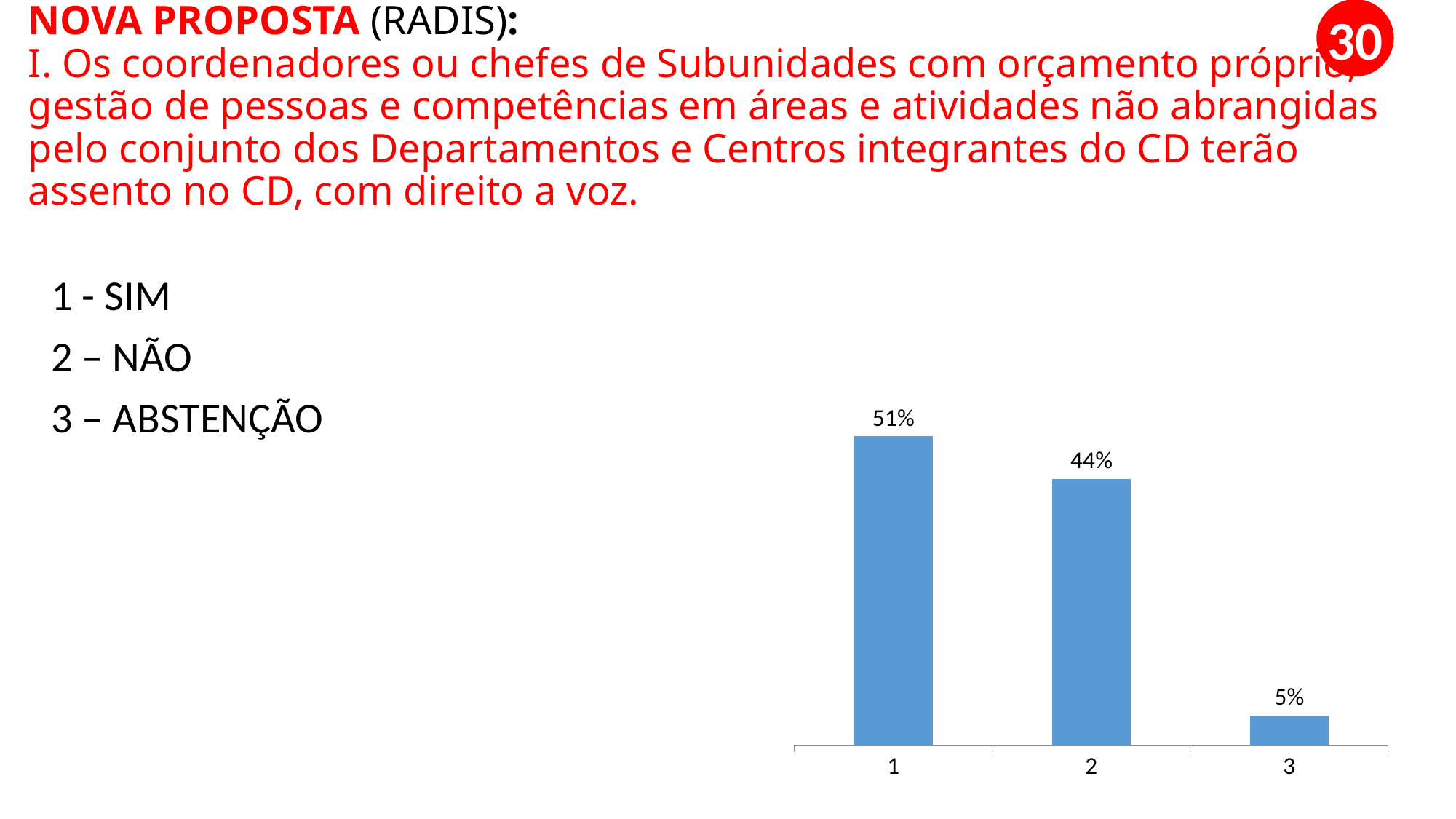
What is the value shown for category 3? 5% What is the value shown for category 1? 51% Which is larger, the value for category 1 or the value for category 3? category 1 What colour are the bars in the chart? blue How many bars are plotted in the chart? 3 What is the value shown for category 2? 44% Which category has the highest value? 1 What is the difference between the values for category 2 and category 3? 39% What kind of chart is shown on the slide? bar chart What is the difference between the values for category 1 and category 2? 7% Which category has the lowest value? 3 Do the values rise or fall from category 1 to category 3? fall